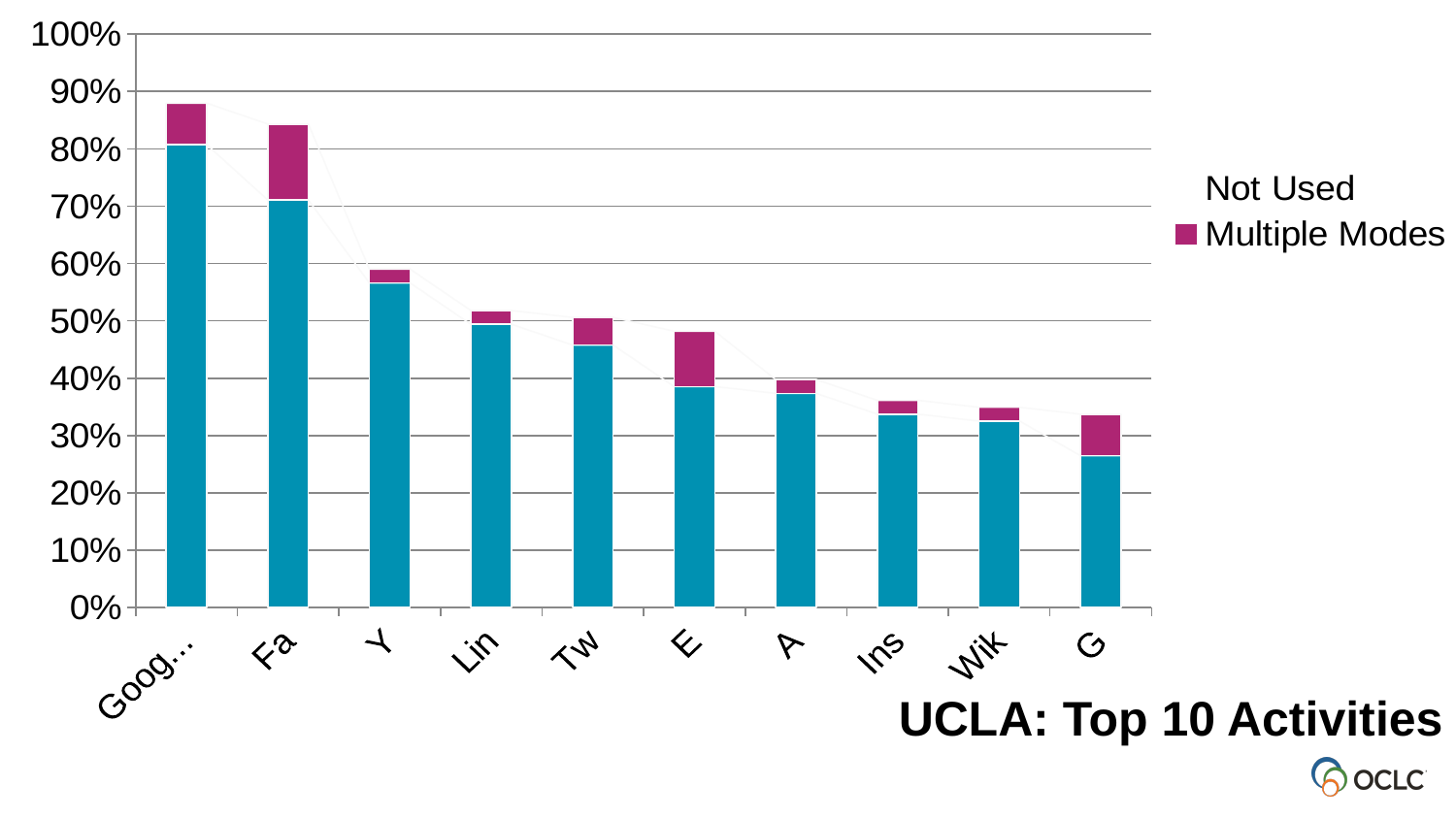
How many series does the legend list? 2 What is the title of the chart? UCLA: Top 10 Activities Is the total stacked value for Y greater or less than 50%? greater Which has the larger Multiple Modes (magenta) segment, Fa or Y? Fa Which category has the tallest stacked bar? Goog... How many categories are plotted along the x axis? 10 Is the total stacked value for Fa greater or less than 80%? greater Is the total stacked value for G greater or less than 30%? greater What kind of chart is shown on the slide? stacked bar chart Which category has the smallest teal (bottom) segment? G Do the stacked bar totals rise or fall from left to right along the x axis? fall